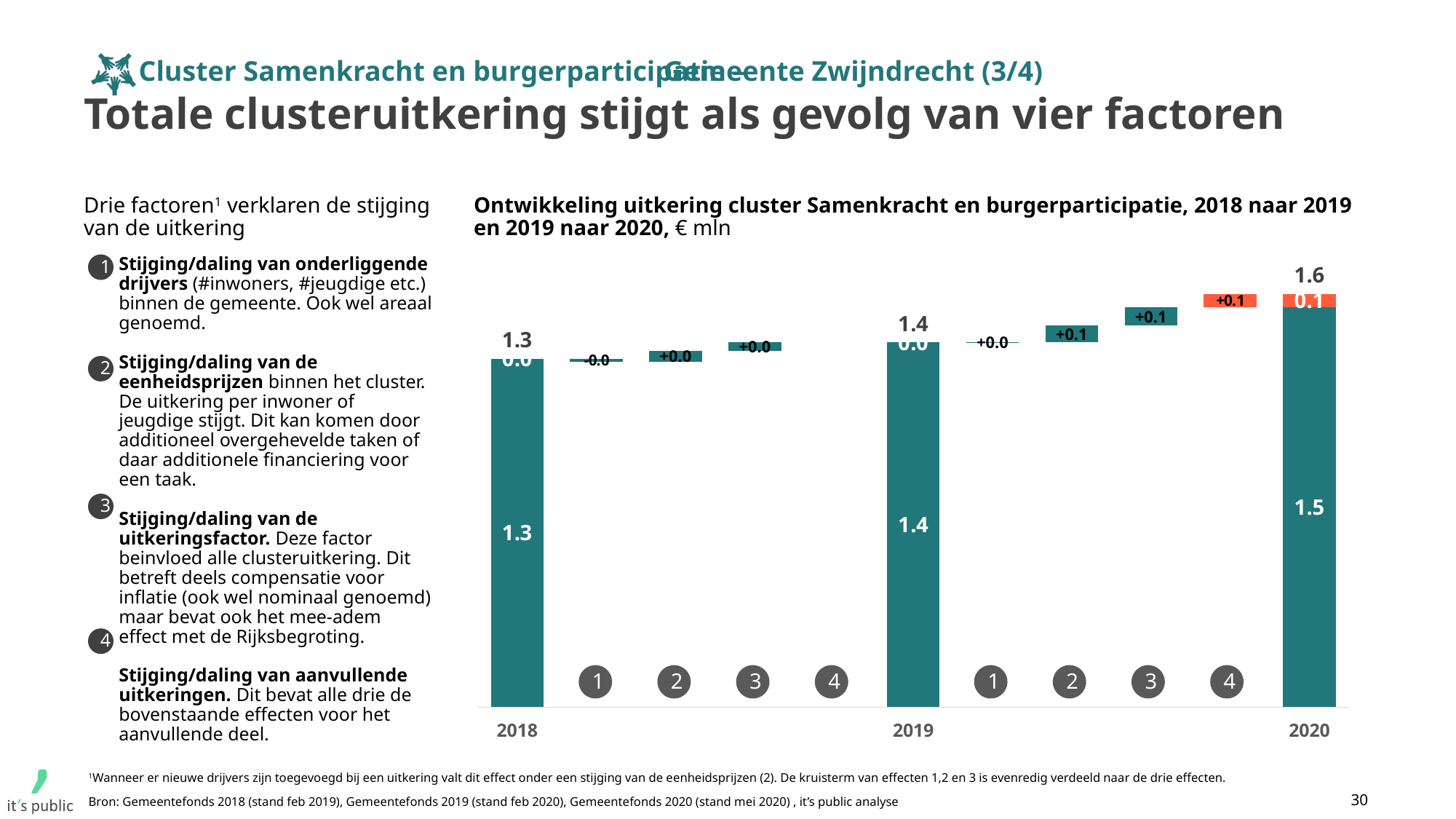
What is the value of the orange segment on top of the 2020 bar? 0.1 Which year has the lowest total cluster payment? 2018 What is the total value shown above the 2019 bar? 1.4 Do the yearly totals rise or fall from 2018 to 2020? rise What is the total value shown above the 2018 bar? 1.3 What is the value of the large teal segment of the 2020 bar? 1.5 In what unit are the values in the chart expressed? € mln What is the difference between the 2020 total and the 2018 total? 0.3 What is the value of factor 4 in the step from 2019 to 2020? +0.1 What is the total value shown above the 2020 bar? 1.6 Which year has the highest total cluster payment? 2020 What is the value of factor 2 in the step from 2019 to 2020? +0.1